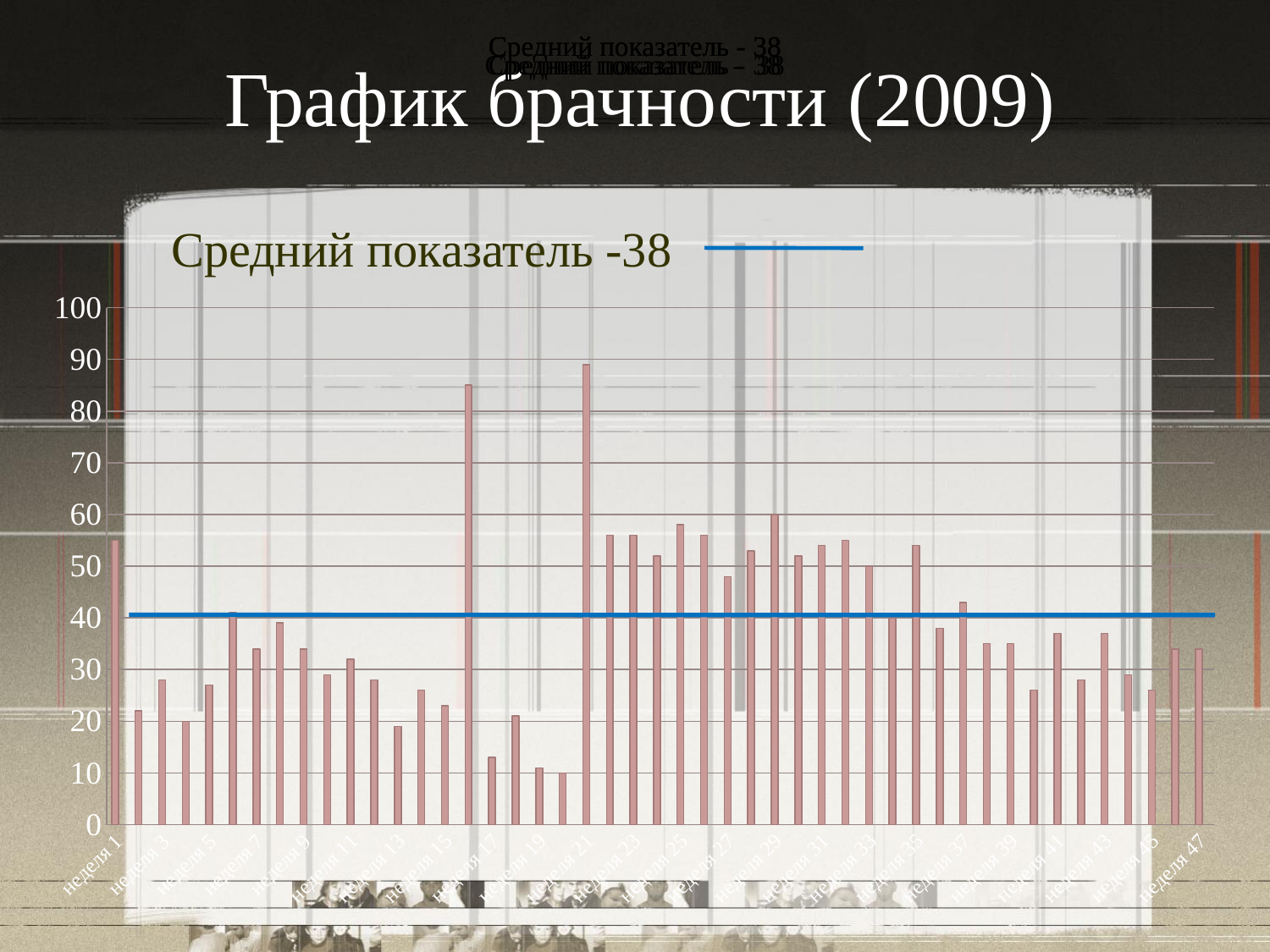
Which week has the highest bar on the chart? неделя 21 Is the value for неделя 20 greater or less than 20? less What is the title of the chart? График брачности (2009) Which is larger, the value for неделя 17 or the value for неделя 47? неделя 47 What kind of chart is shown on the slide? bar chart Is the value for неделя 1 greater or less than 50? greater How many weeks (bars) are plotted on the chart? 47 Is the value for неделя 21 greater or less than 80? greater What value does the blue horizontal line on the chart represent, according to its label? Средний показатель -38 Which is larger, the value for неделя 21 or the value for неделя 1? неделя 21